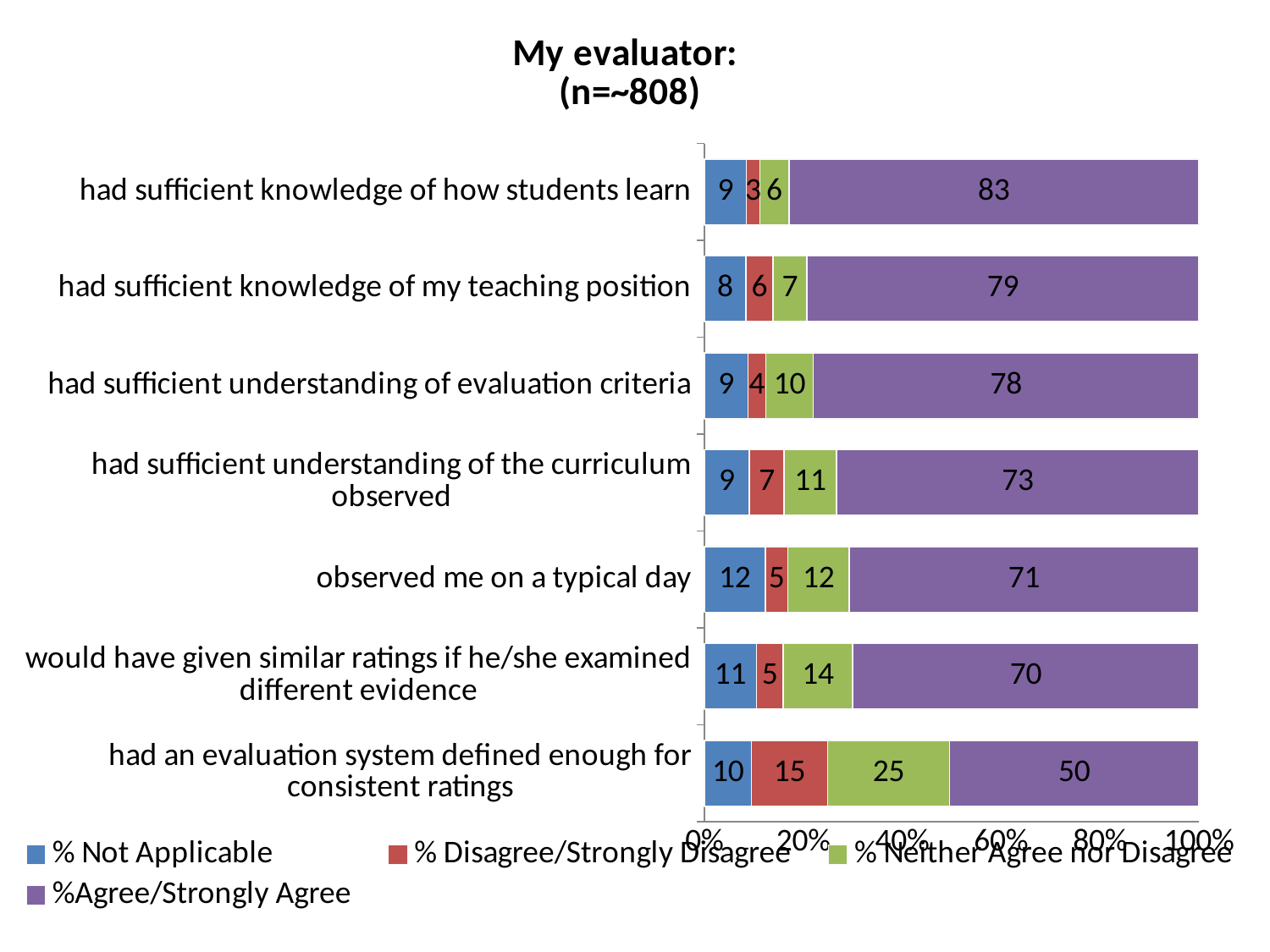
How many categories (statements) are plotted in the chart? 7 What is the % Not Applicable value for 'observed me on a typical day'? 12 Which has the larger % Disagree/Strongly Disagree value: 'had an evaluation system defined enough for consistent ratings' or 'had sufficient knowledge of how students learn'? had an evaluation system defined enough for consistent ratings Which statement has the lowest %Agree/Strongly Agree value? had an evaluation system defined enough for consistent ratings Which statement has the highest %Agree/Strongly Agree value? had sufficient knowledge of how students learn How many series does the legend list? 4 What kind of chart is shown on the slide? stacked bar chart What is the title of the chart? My evaluator: (n=~808) What is the %Agree/Strongly Agree value for 'had sufficient knowledge of how students learn'? 83 What is the difference between the %Agree/Strongly Agree values for 'had sufficient knowledge of my teaching position' and 'had an evaluation system defined enough for consistent ratings'? 29 What is the % Disagree/Strongly Disagree value for 'had sufficient understanding of the curriculum observed'? 7 What is the % Neither Agree nor Disagree value for 'had an evaluation system defined enough for consistent ratings'? 25